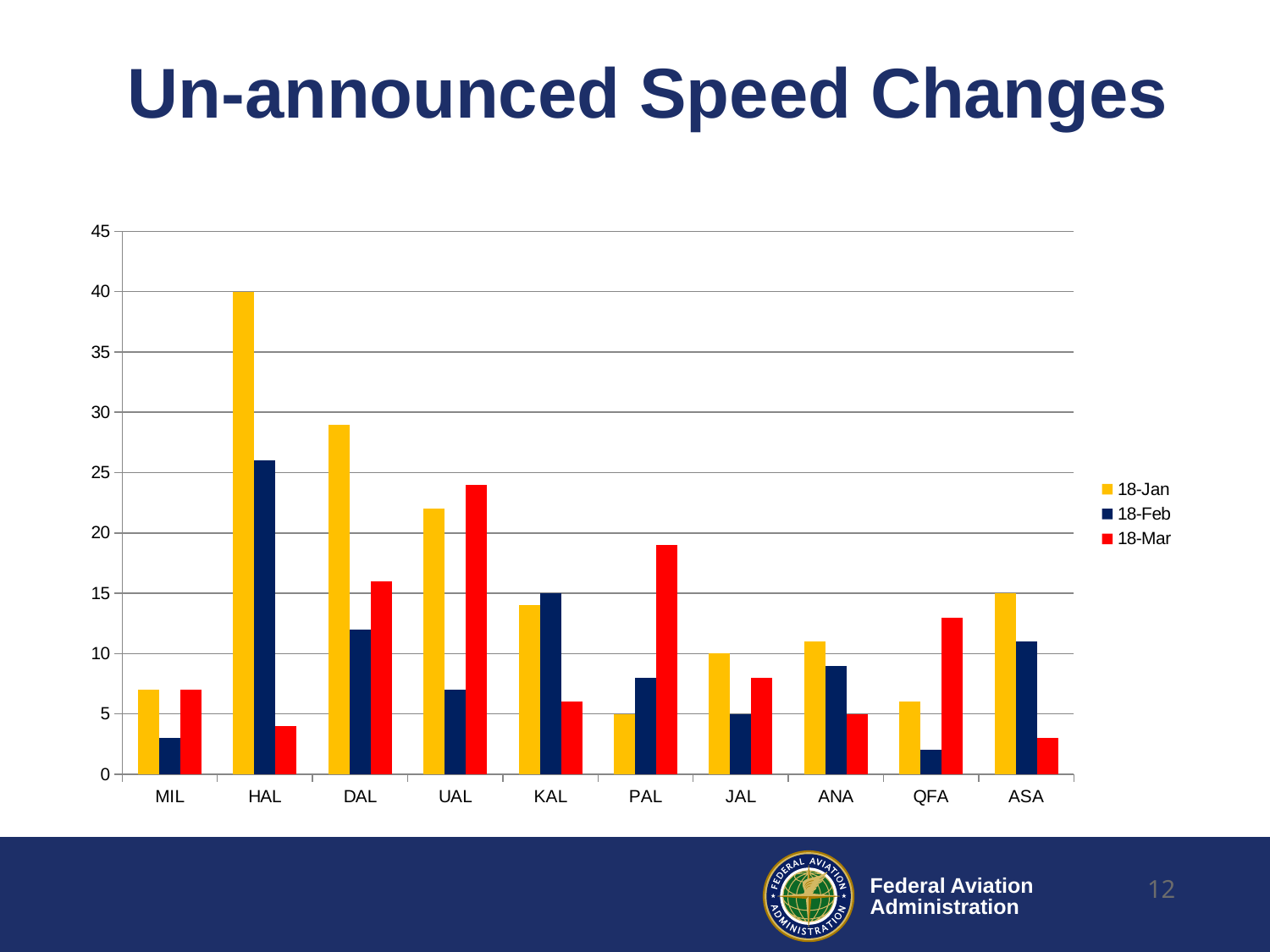
For PAL, which is larger: the 18-Jan value or the 18-Mar value? 18-Mar Is the 18-Jan value for DAL greater or less than 25? greater How many airline categories are shown on the x axis? 10 What is the 18-Jan value for HAL? 40 What kind of chart is shown on the slide? bar chart Is the 18-Feb value for QFA greater or less than 5? less What is the 18-Feb value for KAL? 15 What is the 18-Jan value for JAL? 10 What is the title of the chart? Un-announced Speed Changes How many series does the legend list? 3 Which airline has the highest 18-Mar value? UAL Which airline has the highest 18-Jan value? HAL